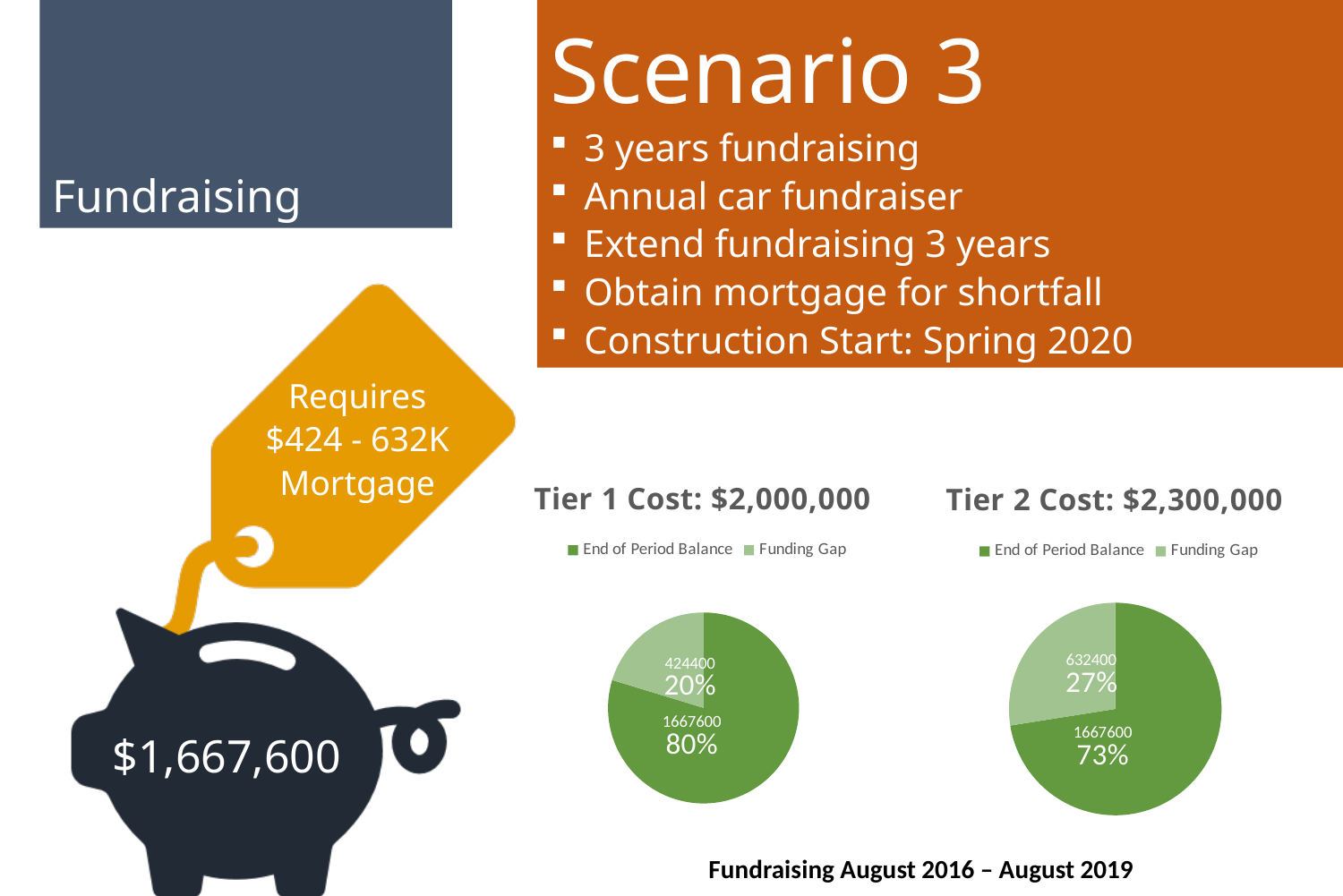
What type of chart is the Tier 1 Cost: $2,000,000 chart? Pie chart In the Tier 2 Cost: $2,300,000 chart, which slice is larger, End of Period Balance or Funding Gap? End of Period Balance How many entries does the legend of the Tier 1 Cost: $2,000,000 chart list? 2 In the Tier 2 Cost: $2,300,000 chart, what percentage share does the Funding Gap slice have? 27% In the Tier 1 Cost: $2,000,000 chart, what is the value of the End of Period Balance slice? 1667600 In the Tier 1 Cost: $2,000,000 chart, what is the value of the Funding Gap slice? 424400 In the Tier 1 Cost: $2,000,000 chart, what is the difference between the End of Period Balance and Funding Gap values? 1243200 In the Tier 1 Cost: $2,000,000 chart, what percentage share does the End of Period Balance slice have? 80% In the Tier 2 Cost: $2,300,000 chart, what percentage share does the End of Period Balance slice have? 73% In the Tier 2 Cost: $2,300,000 chart, what is the value of the Funding Gap slice? 632400 How many slices does the Tier 2 Cost: $2,300,000 pie chart have? 2 In the Tier 1 Cost: $2,000,000 chart, which slice is the smallest? Funding Gap